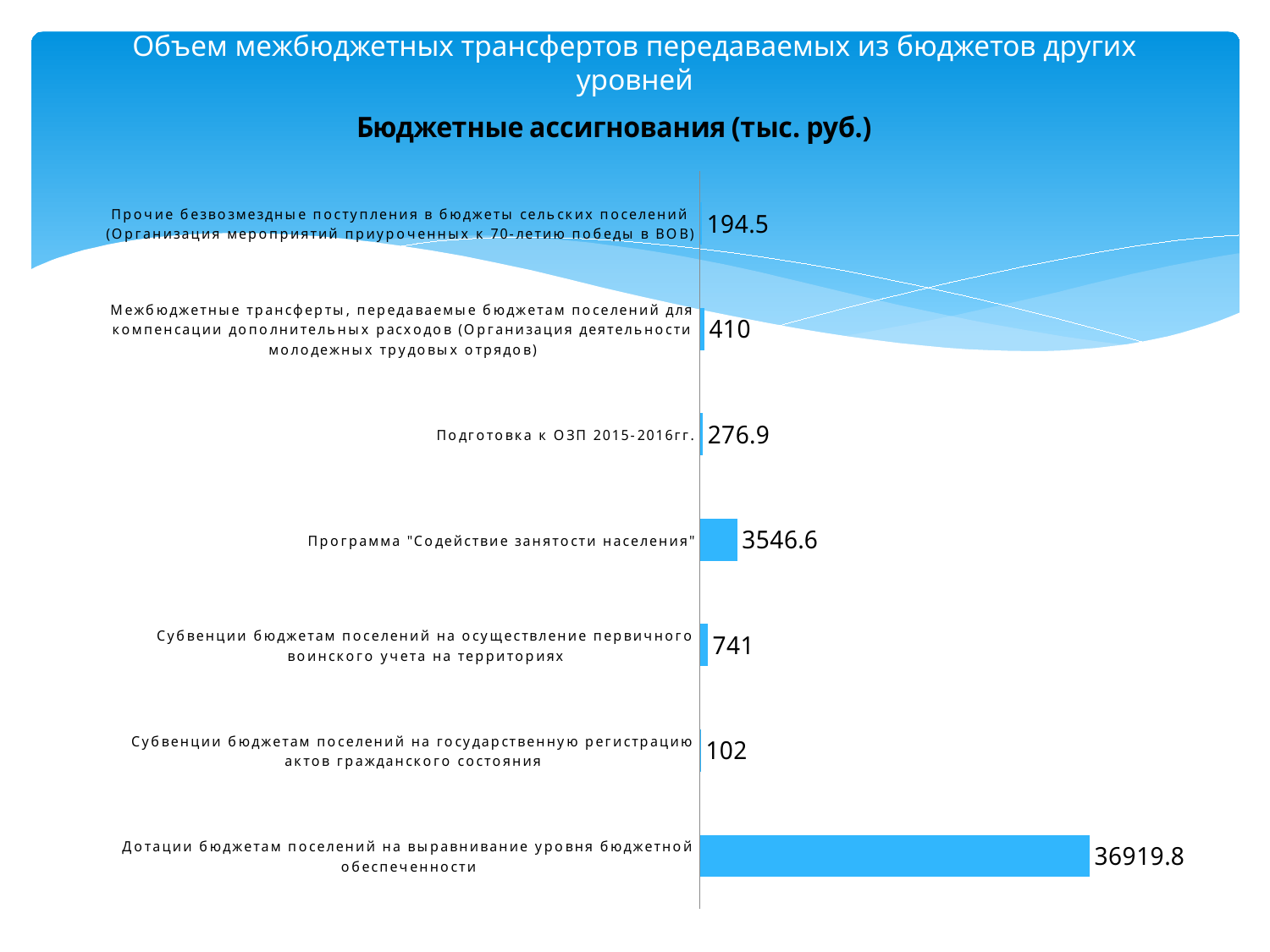
What is the difference between the values for "Программа "Содействие занятости населения"" and "Субвенции бюджетам поселений на осуществление первичного воинского учета на территориях"? 2805.6 What is the value for "Дотации бюджетам поселений на выравнивание уровня бюджетной обеспеченности"? 36919.8 What is the difference between the values for "Прочие безвозмездные поступления в бюджеты сельских поселений" and "Субвенции бюджетам поселений на государственную регистрацию актов гражданского состояния"? 92.5 Which category has the highest value? Дотации бюджетам поселений на выравнивание уровня бюджетной обеспеченности What kind of chart is shown on the slide? Bar chart Which category has the lowest value? Субвенции бюджетам поселений на государственную регистрацию актов гражданского состояния What is the value for "Подготовка к ОЗП 2015-2016гг."? 276.9 What is the value for "Субвенции бюджетам поселений на осуществление первичного воинского учета на территориях"? 741 What is the value for "Программа "Содействие занятости населения""? 3546.6 Which is larger: the value for "Межбюджетные трансферты, передаваемые бюджетам поселений для компенсации дополнительных расходов" or the value for "Подготовка к ОЗП 2015-2016гг."? Межбюджетные трансферты, передаваемые бюджетам поселений для компенсации дополнительных расходов What is the title of the chart? Бюджетные ассигнования (тыс. руб.) How many categories are shown in the chart? 7